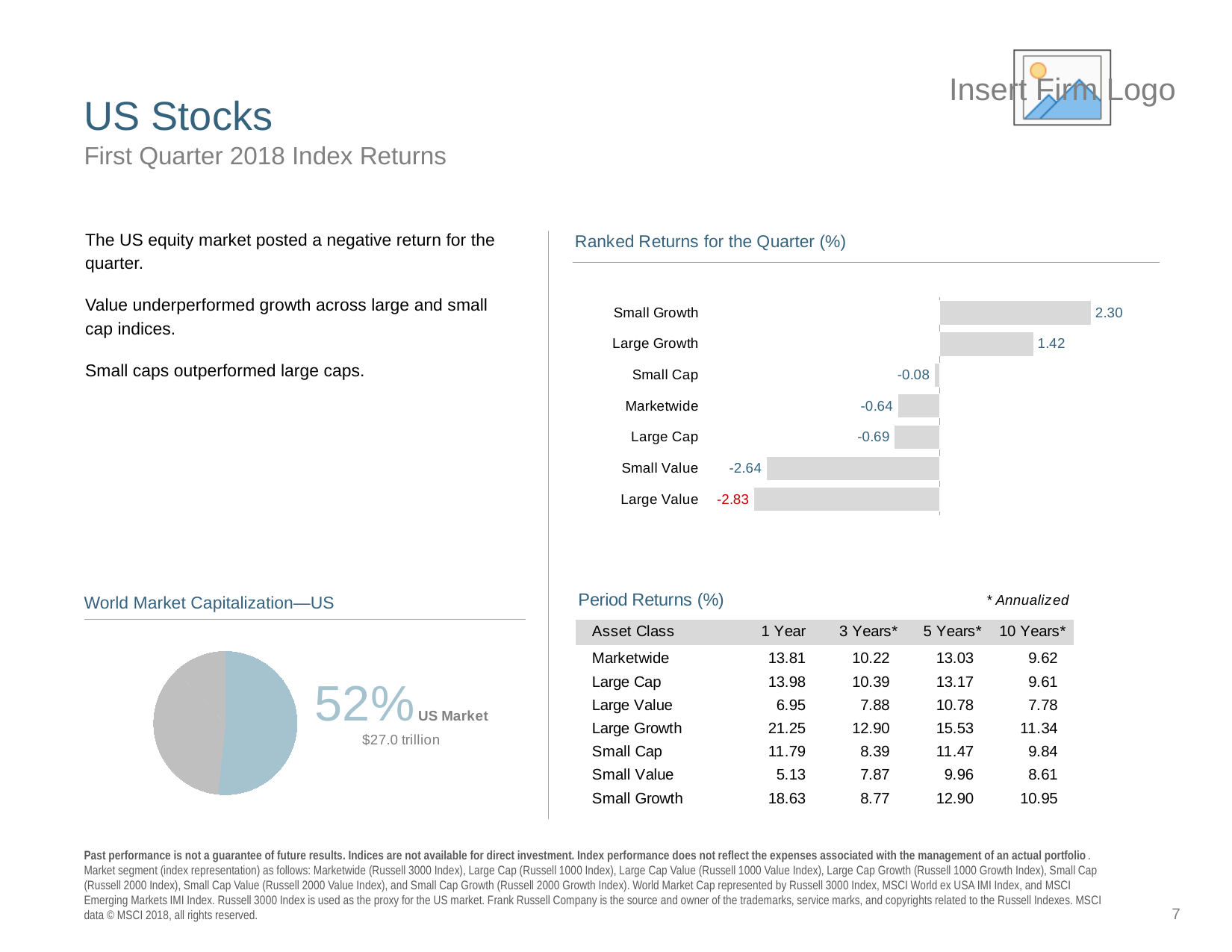
In the Ranked Returns for the Quarter (%) chart, which category has the highest value? Small Growth In the Ranked Returns for the Quarter (%) chart, which is larger, the value for Small Cap or the value for Large Cap? Small Cap In the Ranked Returns for the Quarter (%) chart, what is the value for Marketwide? -0.64 In the Ranked Returns for the Quarter (%) chart, what is the value for Large Value? -2.83 What kind of chart is the Ranked Returns for the Quarter (%) chart? Bar chart In the Ranked Returns for the Quarter (%) chart, which category has the lowest value? Large Value In the Ranked Returns for the Quarter (%) chart, how many categories have negative values? 5 How many categories are shown in the Ranked Returns for the Quarter (%) chart? 7 In the Ranked Returns for the Quarter (%) chart, what is the value for Small Growth? 2.30 In the World Market Capitalization—US chart, what share of the pie does the US Market represent? 52% In the Ranked Returns for the Quarter (%) chart, what is the difference between the values for Small Growth and Large Growth? 0.88 What kind of chart is the World Market Capitalization—US chart? Pie chart